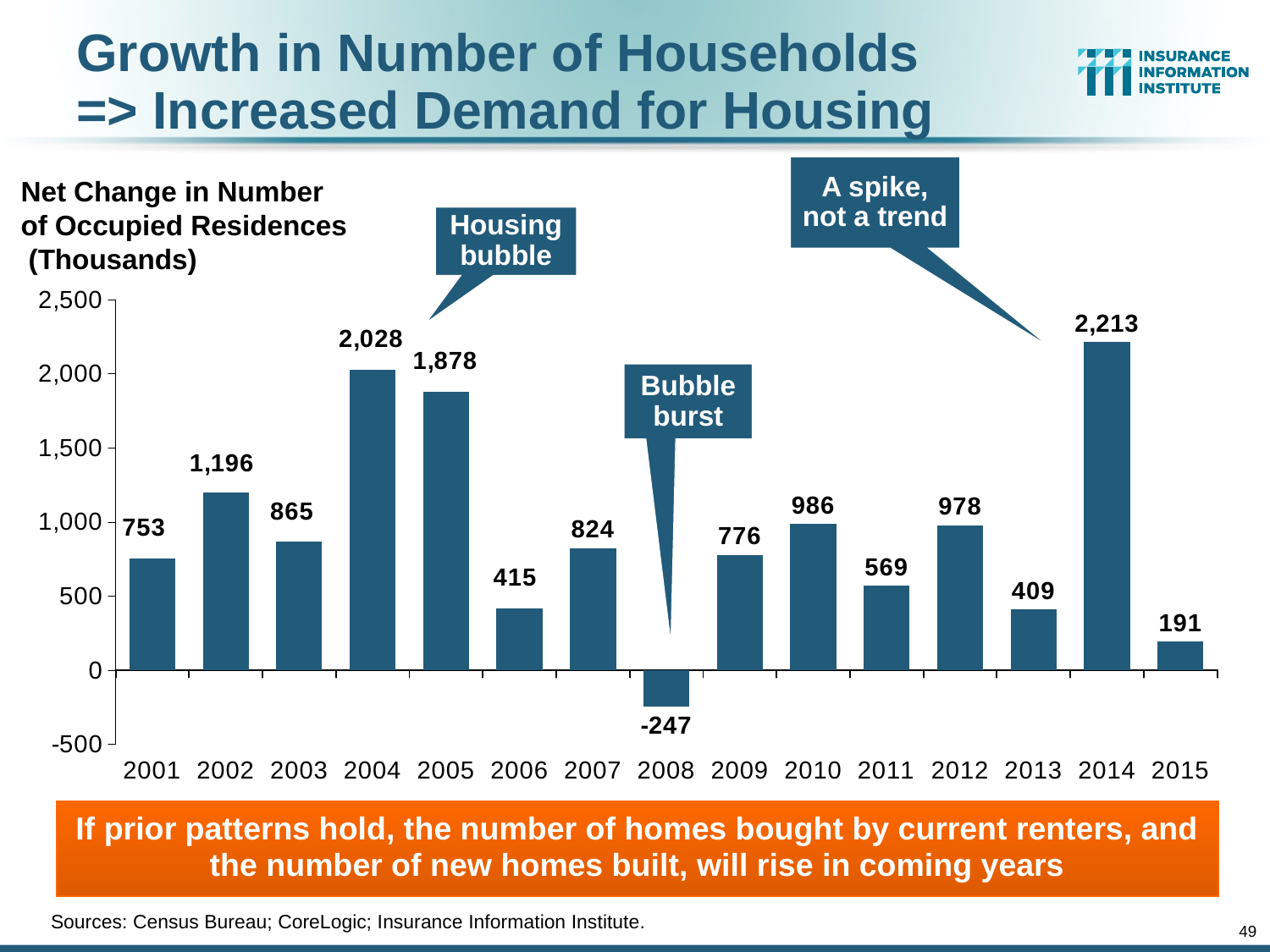
Which year has a larger value, 2010 or 2012? 2010 Which year is labelled with the callout 'A spike, not a trend'? 2014 Which year has the lowest net change in number of occupied residences? 2008 What is the net change in number of occupied residences for 2004? 2,028 What is the value for 2015? 191 Which year has the highest net change in number of occupied residences? 2014 What value is shown for 2008? -247 Is the value for 2002 greater or less than 1,000? greater What kind of chart is shown on the slide? Bar chart What is the difference between the values for 2014 and 2013? 1,804 Do the values rise or fall from 2012 to 2013? Fall How many years are shown on the x axis? 15